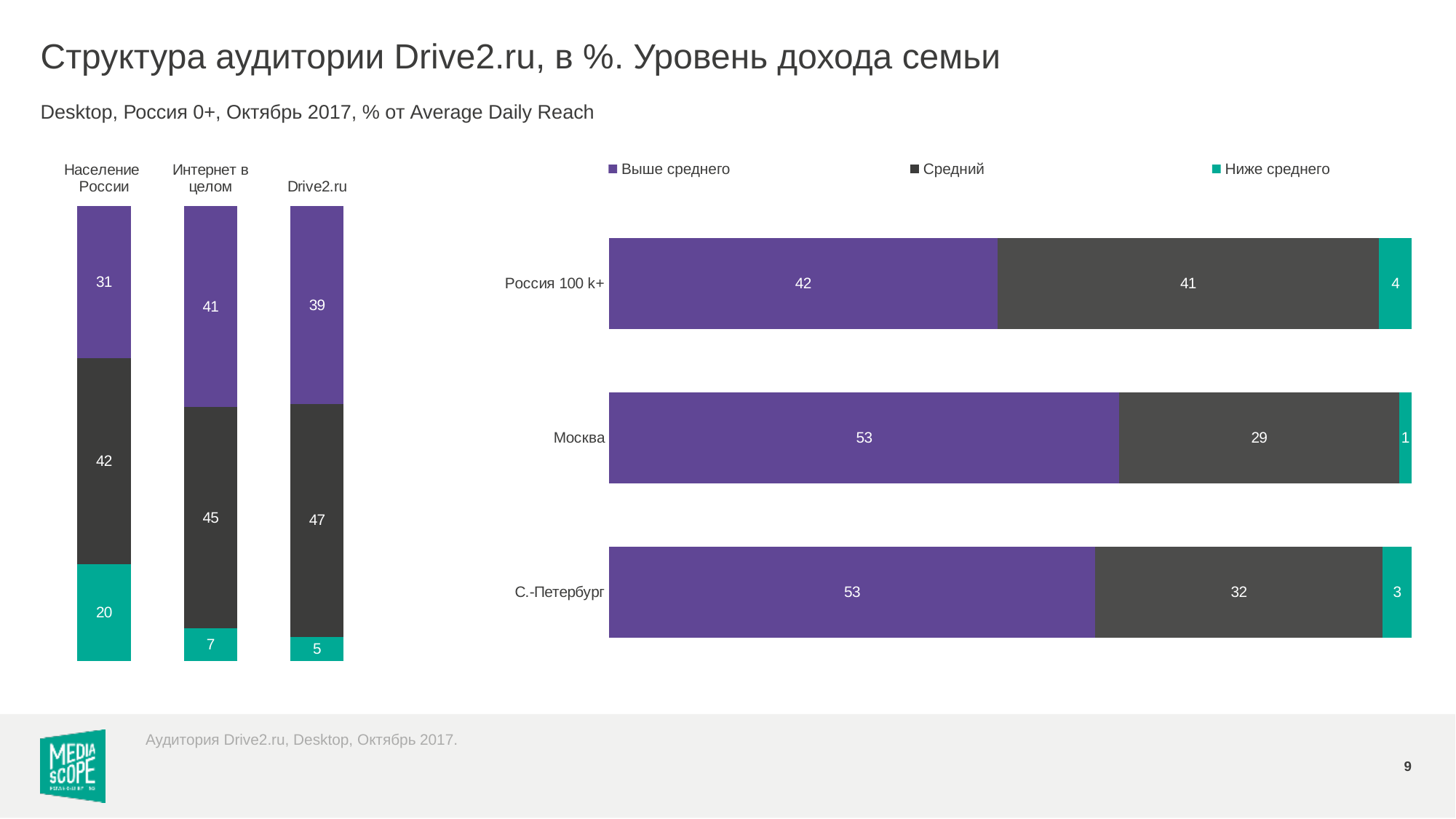
In the left chart, which category has the highest 'Выше среднего' value? Интернет в целом In the right chart, what is the value of the 'Выше среднего' segment for 'Москва'? 53 In the right chart, what is the value of the 'Ниже среднего' segment for 'Россия 100 k+'? 4 In the right chart, which category has the lowest 'Ниже среднего' value? Москва In the right chart, what is the total of the stacked bar for 'С.-Петербург'? 88 In the left chart, what is the difference between the 'Ниже среднего' values for 'Население России' and 'Drive2.ru'? 15 In the left chart, what is the value of the 'Ниже среднего' segment for 'Население России'? 20 In the left chart, what is the value of the 'Средний' segment for 'Drive2.ru'? 47 How many series does the legend list? 3 In the right chart, which is larger: the 'Средний' value for 'Россия 100 k+' or for 'С.-Петербург'? Россия 100 k+ What type of chart is the right chart? Stacked bar chart How many categories are shown in the right chart? 3